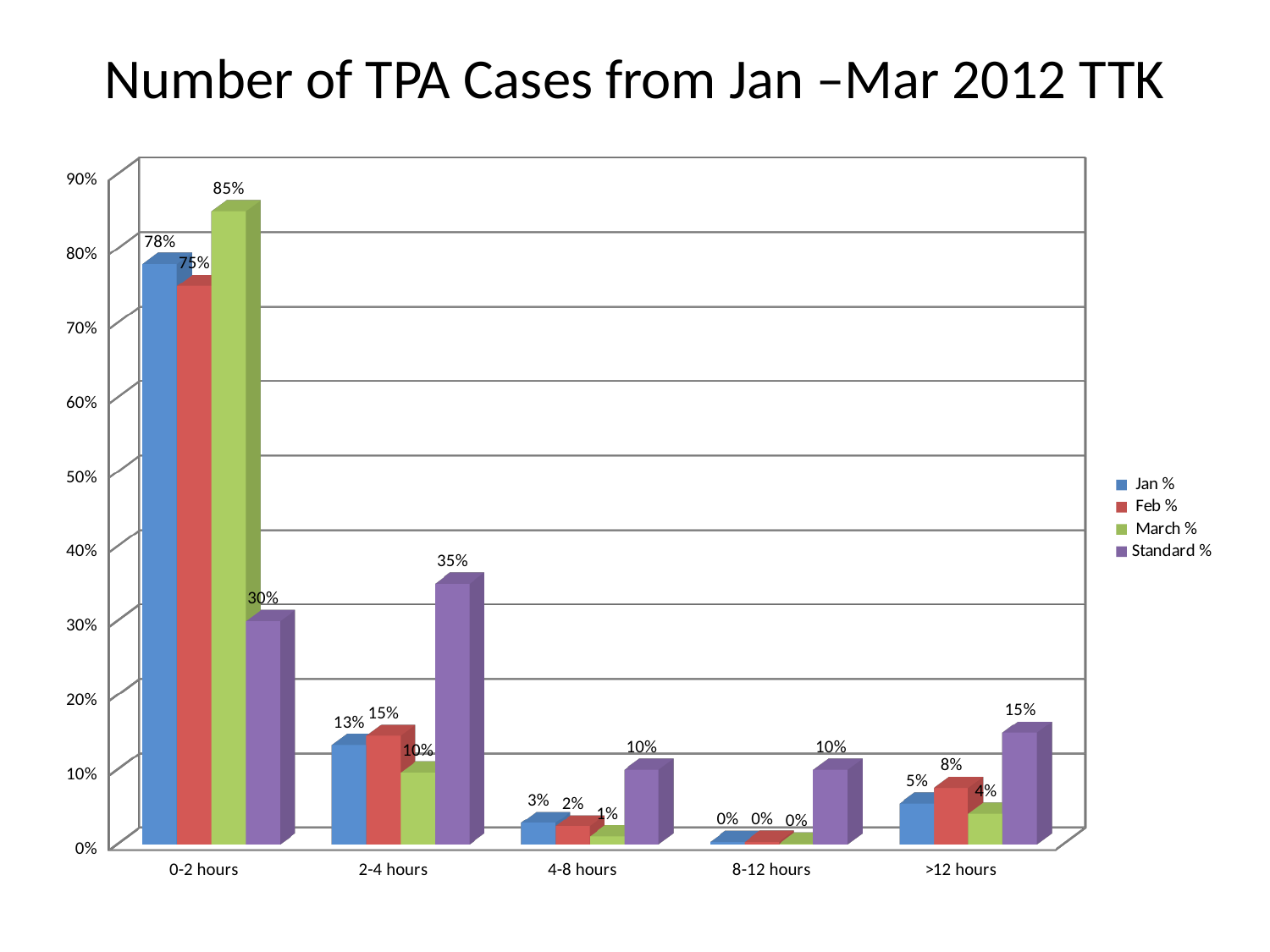
What is the title of the chart? Number of TPA Cases from Jan –Mar 2012 TTK Which category has the lowest Jan % value? 8-12 hours What is the Standard % value for 2-4 hours? 35% What is the difference between the March % and Standard % values for 0-2 hours? 55% Which is larger for 2-4 hours, the Jan % value or the Feb % value? Feb % How many categories are shown on the x axis? 5 What is the March % value for 0-2 hours? 85% What kind of chart is shown on the slide? Bar chart How many series does the legend list? 4 What is the Jan % value for 0-2 hours? 78% Which category has the highest Standard % value? 2-4 hours What is the Feb % value for >12 hours? 8%